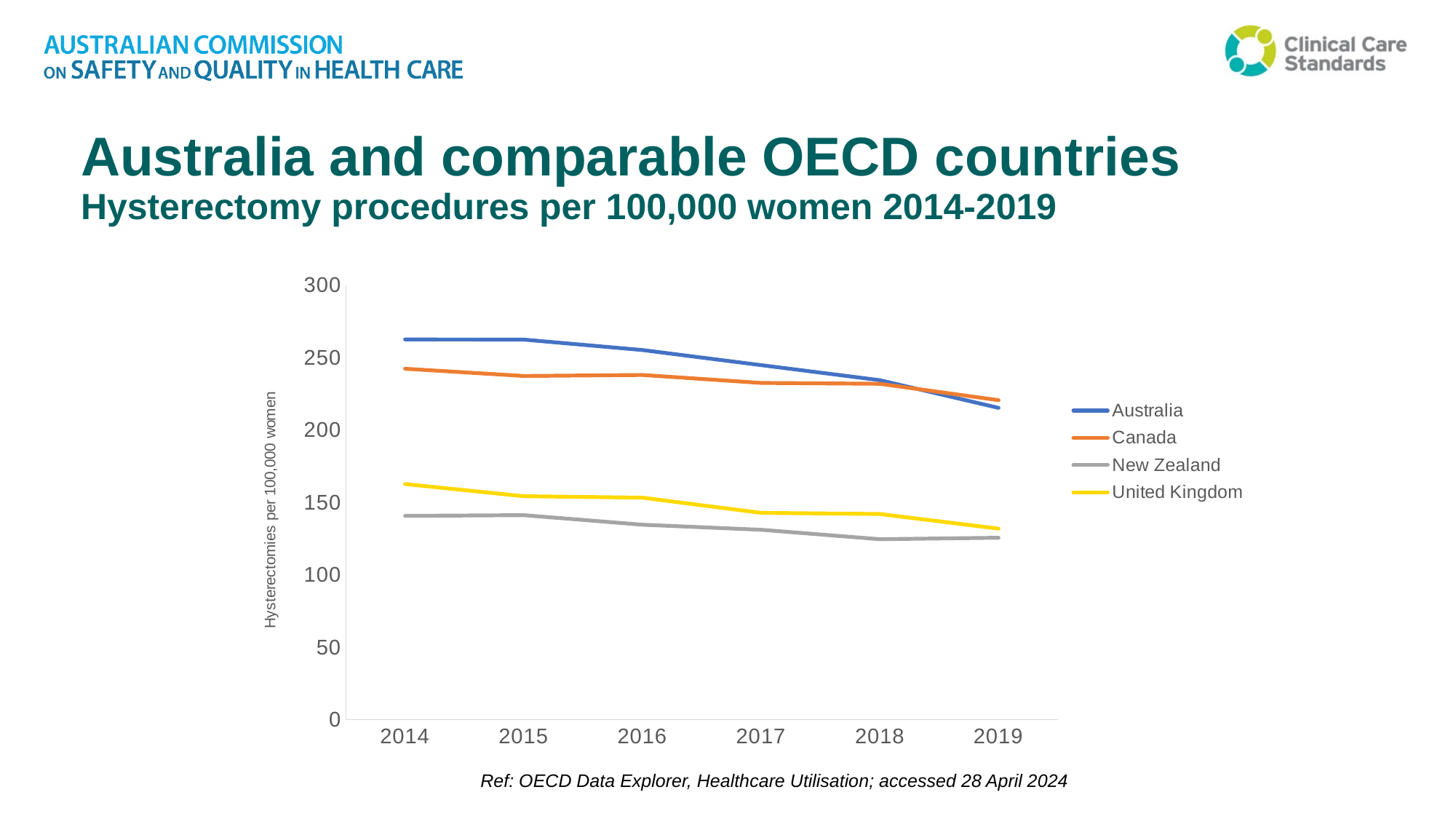
Is the value for Canada in 2014 greater or less than 250? less What type of chart is shown on the slide? line chart Is the value for New Zealand in 2019 greater or less than 150? less In 2014, which is larger: the value for Australia or the value for Canada? Australia Which country has the lowest hysterectomy rate in 2019? New Zealand How many series does the legend list? 4 What is the label on the vertical axis? Hysterectomies per 100,000 women Does the hysterectomy rate for Australia rise or fall from 2014 to 2019? fall Is the value for the United Kingdom in 2014 greater or less than 150? greater Which country has the highest hysterectomy rate in 2014? Australia How many years are shown on the x axis? 6